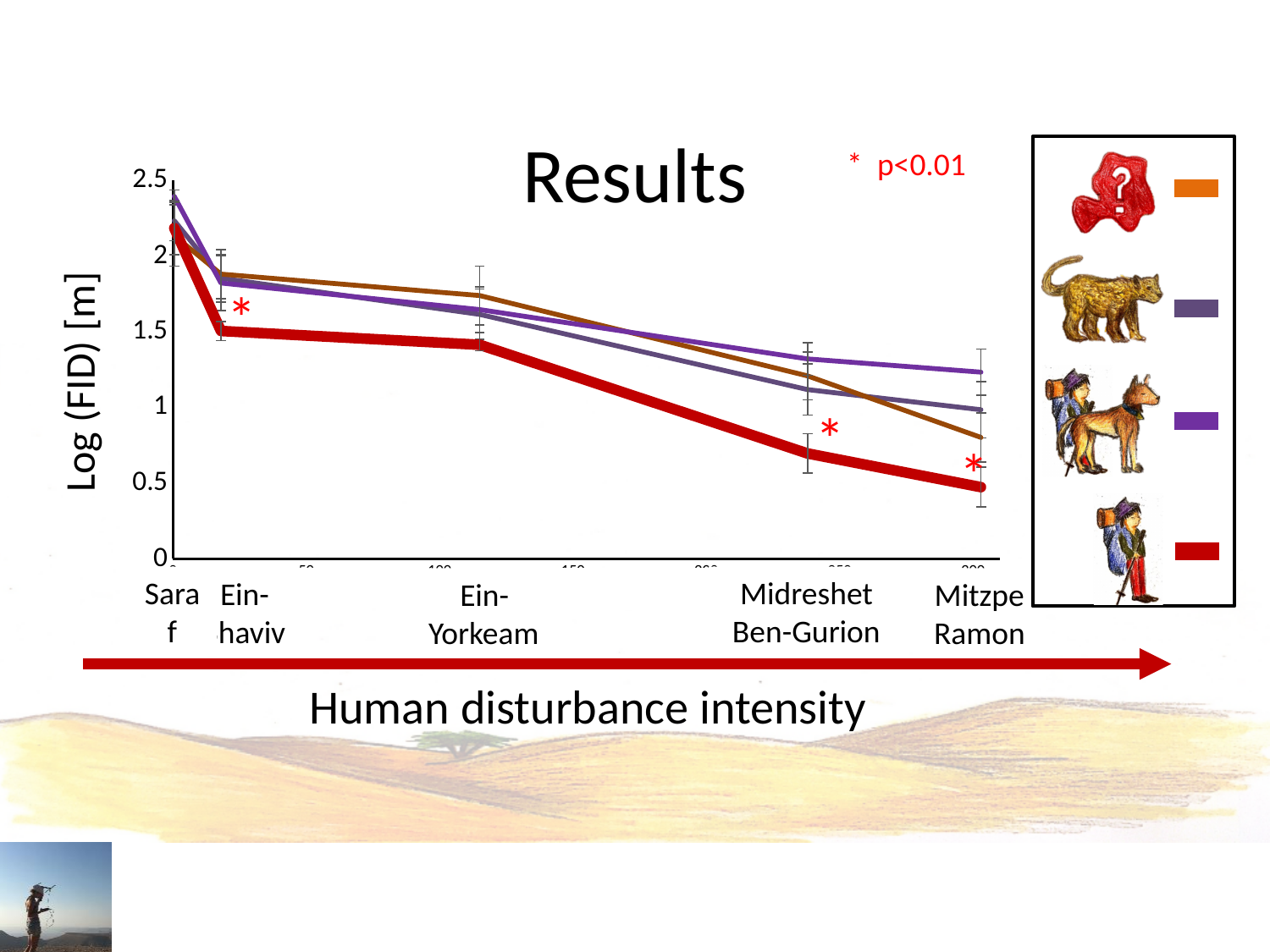
Is the value of the red line at Midreshet Ben-Gurion greater or less than 1? less How many series does the legend on the right of the chart list? 4 At Mitzpe Ramon, which line has the larger value, the purple line or the red line? purple line What is the label of the y axis of the chart? Log (FID) [m] What kind of chart is shown on the slide? line chart Do the values of the red line rise or fall from Saraf to Mitzpe Ramon? fall Is the value of the purple line at Mitzpe Ramon greater or less than 1? greater What label is written under the x axis of the chart? Human disturbance intensity Which line has the lowest value at Mitzpe Ramon? red line How many sites (categories) are labelled along the x axis of the chart? 5 Is the value of the red line at Mitzpe Ramon greater or less than 1? less